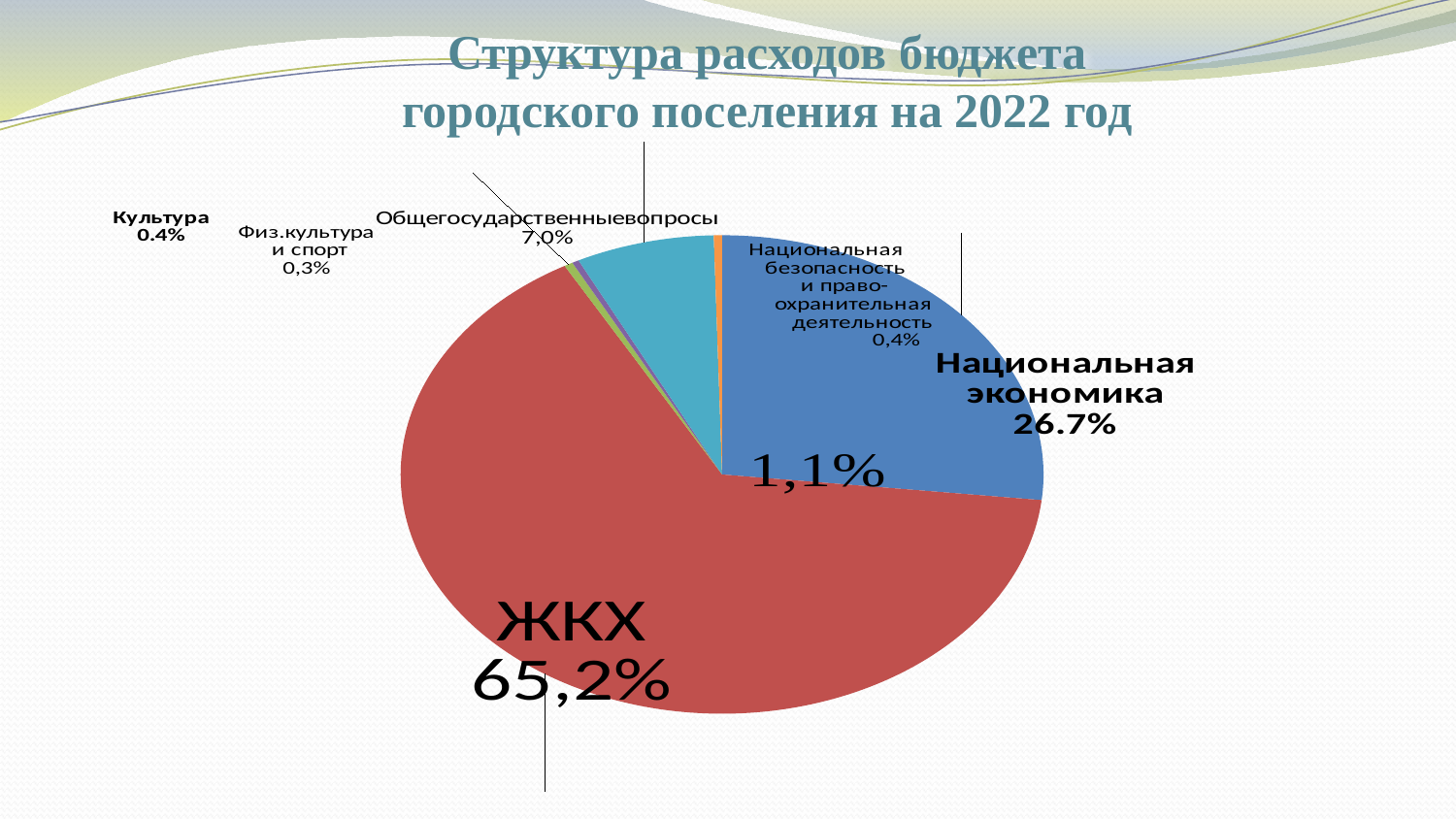
What is the title of the chart on the slide? Структура расходов бюджета городского поселения на 2022 год What is the value shown for Физ.культура и спорт? 0,3% What share of the budget expenditures goes to ЖКХ? 65,2% What is the value shown for Национальная безопасность и правоохранительная деятельность? 0,4% What is the value shown for Культура? 0.4% Is the share for ЖКХ greater or less than 50%? greater What kind of chart is shown on the slide? pie chart Which labelled category has the smallest share of the pie? Физ.культура и спорт Which category has the largest slice of the pie? ЖКХ What is the value shown for Общегосударственные вопросы? 7,0% Which is larger, the share for Национальная экономика or the share for Общегосударственные вопросы? Национальная экономика What is the value shown for Национальная экономика? 26.7%